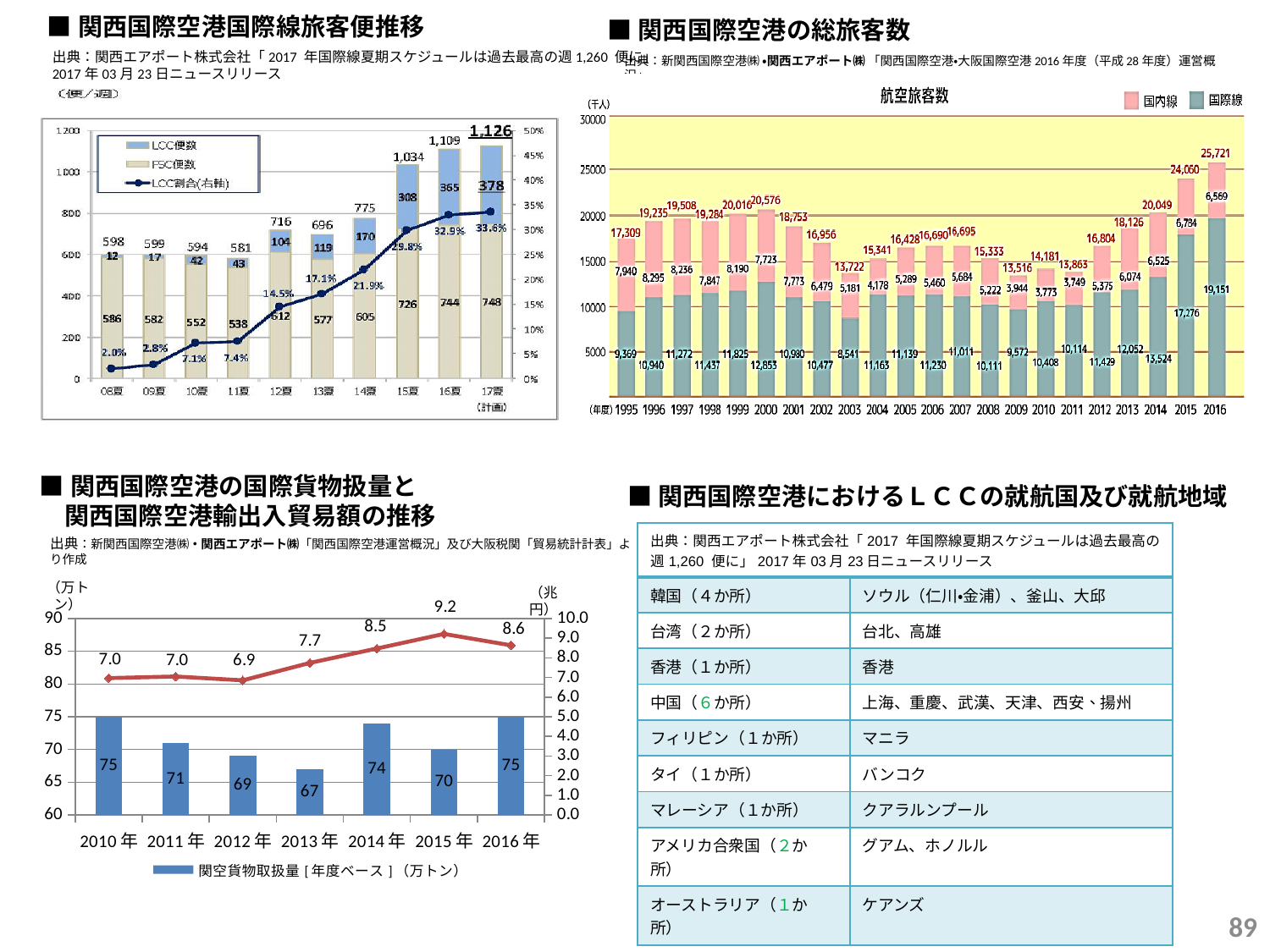
In the top-right chart (航空旅客数), which year has the highest total passenger number? 2016 In the bottom-left chart (関西国際空港の国際貨物扱量と関西国際空港輸出入貿易額の推移), what is the cargo volume (万トン) for 2013年? 67 In the bottom-left chart (関西国際空港の国際貨物扱量と関西国際空港輸出入貿易額の推移), what is the line value (兆円) for 2015年? 9.2 In the top-left chart (関西国際空港国際線旅客便推移), what is the difference between the LCC便数 for 17夏 and 16夏? 13 In the top-right chart (航空旅客数), what is the 国際線 value for 2016? 19,151 In the top-right chart (航空旅客数), how many series does the legend list? 2 In the bottom-left chart (関西国際空港の国際貨物扱量と関西国際空港輸出入貿易額の推移), which year has the lowest cargo volume bar? 2013年 In the top-left chart (関西国際空港国際線旅客便推移), what is the LCC割合 for 16夏? 32.9% In the bottom-left chart (関西国際空港の国際貨物扱量と関西国際空港輸出入貿易額の推移), how many years are shown on the x axis? 7 In the bottom-left chart (関西国際空港の国際貨物扱量と関西国際空港輸出入貿易額の推移), what is the difference between the line values for 2015年 and 2016年? 0.6 In the top-right chart (航空旅客数), what is the total passenger number (千人) for 2016? 25,721 In the top-left chart (関西国際空港国際線旅客便推移), what is the total number of flights per week for 17夏? 1,126